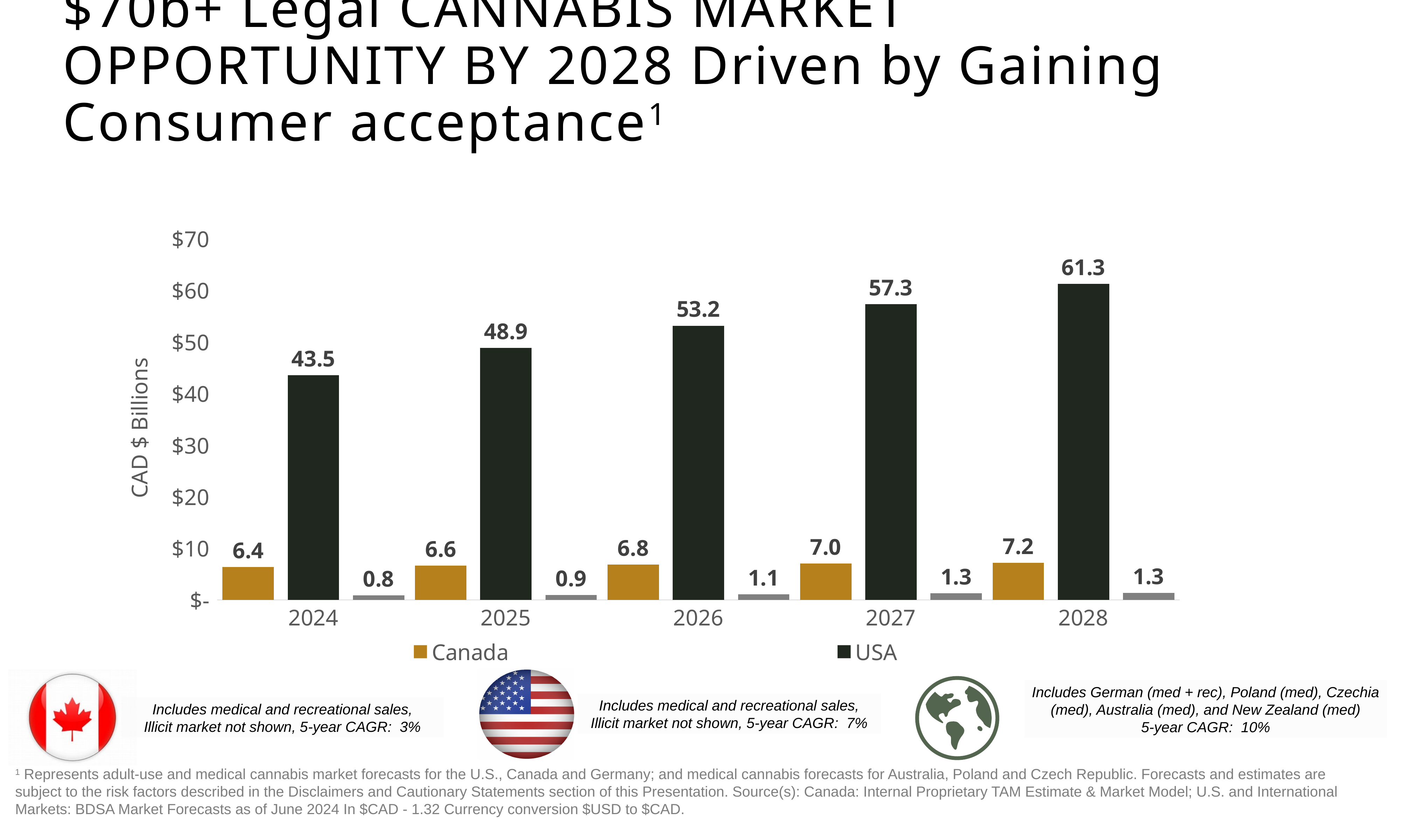
In which year is the Canada value lowest? 2024 How many series does the legend list? 2 Do the USA values rise or fall from 2024 to 2028? rise Which is larger, the Canada value for 2025 or the Canada value for 2028? Canada 2028 What is the USA value for 2028? 61.3 What is the difference between the USA values for 2028 and 2024? 17.8 In which year is the USA value highest? 2028 Is the USA value for 2027 greater or less than $50? greater What is the Canada value for 2027? 7.0 What is the USA value for 2026? 53.2 How many years are shown on the x axis? 5 What is the Canada value for 2024? 6.4